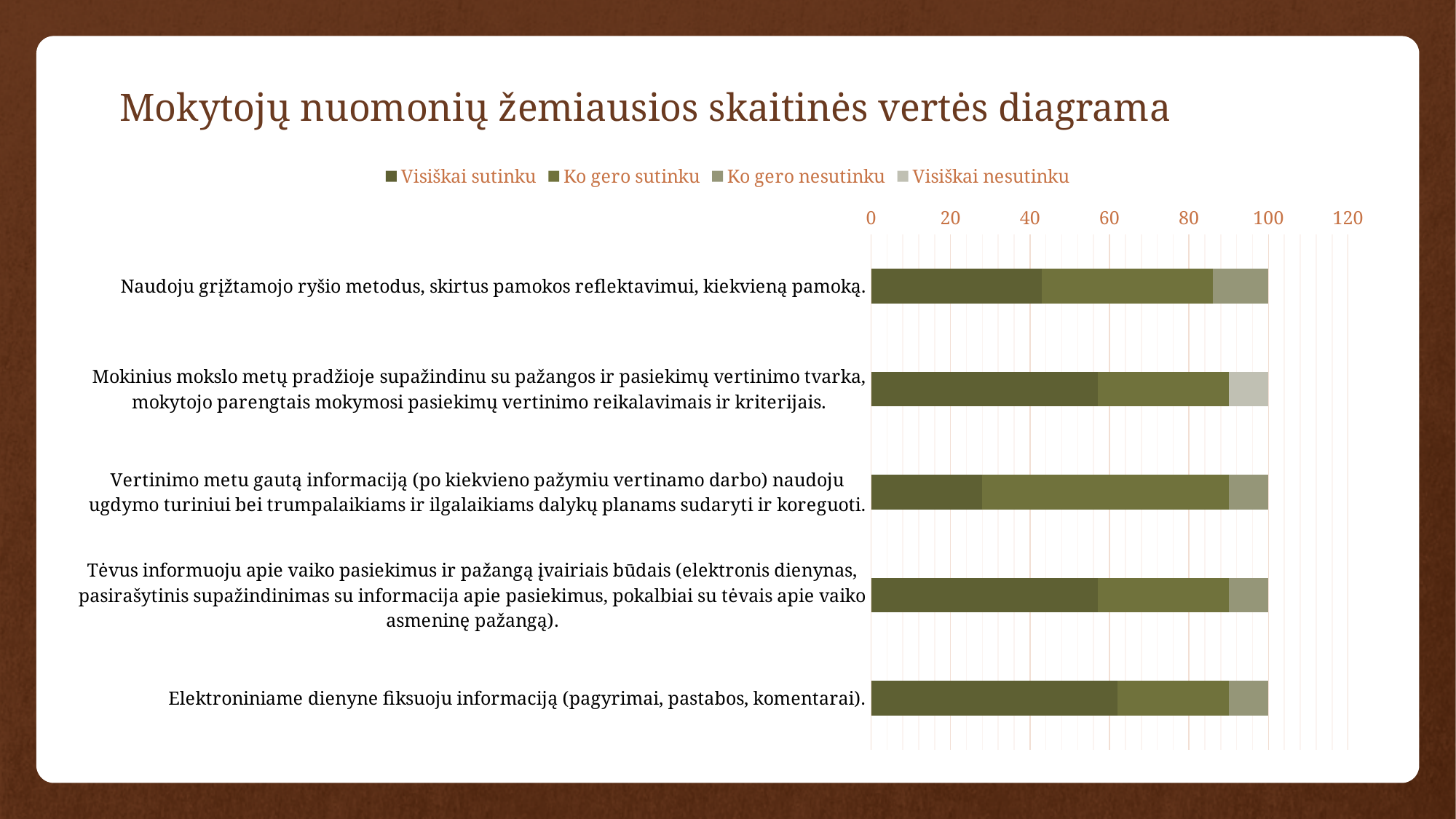
Which category has the largest 'Ko gero sutinku' segment? Vertinimo metu gautą informaciją (po kiekvieno pažymiu vertinamo darbo) naudoju ugdymo turiniui bei trumpalaikiams ir ilgalaikiams dalykų planams sudaryti ir koreguoti. How many categories (statements) are plotted in the chart? 5 Which category has the lowest 'Visiškai sutinku' value? Vertinimo metu gautą informaciją (po kiekvieno pažymiu vertinamo darbo) naudoju ugdymo turiniui bei trumpalaikiams ir ilgalaikiams dalykų planams sudaryti ir koreguoti. How many series does the legend list? 4 Which category is the only one with a visible 'Visiškai nesutinku' segment? Mokinius mokslo metų pradžioje supažindinu su pažangos ir pasiekimų vertinimo tvarka, mokytojo parengtais mokymosi pasiekimų vertinimo reikalavimais ir kriterijais. Is the 'Visiškai sutinku' value for 'Mokinius mokslo metų pradžioje supažindinu su pažangos ir pasiekimų vertinimo tvarka, mokytojo parengtais mokymosi pasiekimų vertinimo reikalavimais ir kriterijais.' greater or less than 40? greater Which series is listed first in the legend? Visiškai sutinku What kind of chart is shown on the slide? bar chart What is the title of the chart? Mokytojų nuomonių žemiausios skaitinės vertės diagrama Is the 'Visiškai sutinku' value for 'Elektroniniame dienyne fiksuoju informaciją (pagyrimai, pastabos, komentarai).' greater or less than 40? greater Is the 'Visiškai sutinku' value for 'Vertinimo metu gautą informaciją (po kiekvieno pažymiu vertinamo darbo) naudoju ugdymo turiniui bei trumpalaikiams ir ilgalaikiams dalykų planams sudaryti ir koreguoti.' greater or less than 40? less Which has the larger 'Visiškai sutinku' value: 'Elektroniniame dienyne fiksuoju informaciją (pagyrimai, pastabos, komentarai).' or 'Vertinimo metu gautą informaciją (po kiekvieno pažymiu vertinamo darbo) naudoju ugdymo turiniui bei trumpalaikiams ir ilgalaikiams dalykų planams sudaryti ir koreguoti.'? Elektroniniame dienyne fiksuoju informaciją (pagyrimai, pastabos, komentarai).